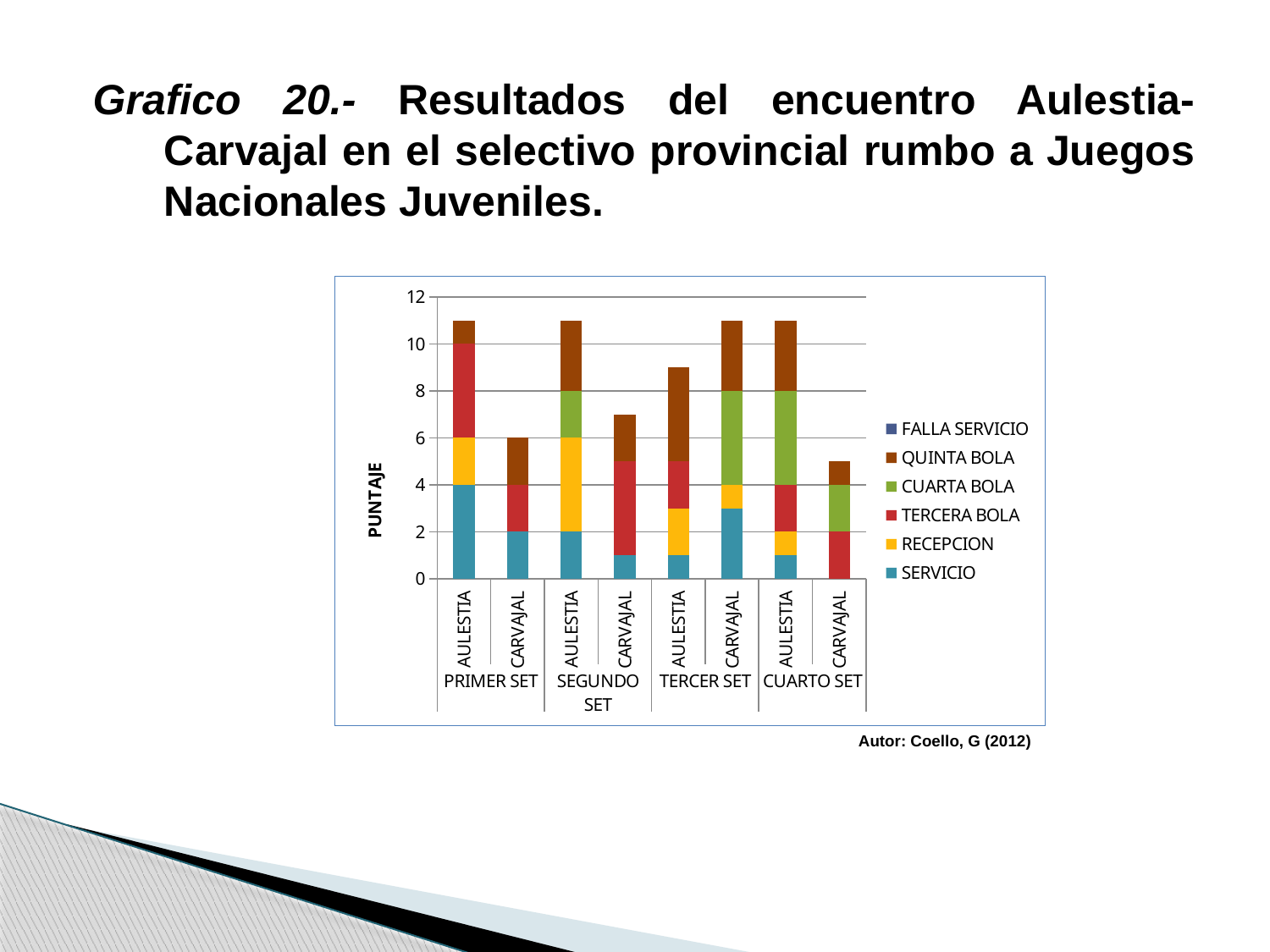
Is the total for CARVAJAL in CUARTO SET greater or less than 6? less What is the total of the CARVAJAL bar in PRIMER SET? 6 Is the total for AULESTIA in PRIMER SET greater or less than 10? greater Is the total for AULESTIA in TERCER SET greater or less than 8? greater What is the title of the vertical axis? PUNTAJE How many series does the legend list? 6 What kind of chart is shown on the slide? Stacked bar chart Which legend entry is shown in blue at the bottom of the stacks? SERVICIO In TERCER SET, which bar is taller, AULESTIA or CARVAJAL? CARVAJAL How many bars are plotted in the chart? 8 In PRIMER SET, which bar is taller, AULESTIA or CARVAJAL? AULESTIA